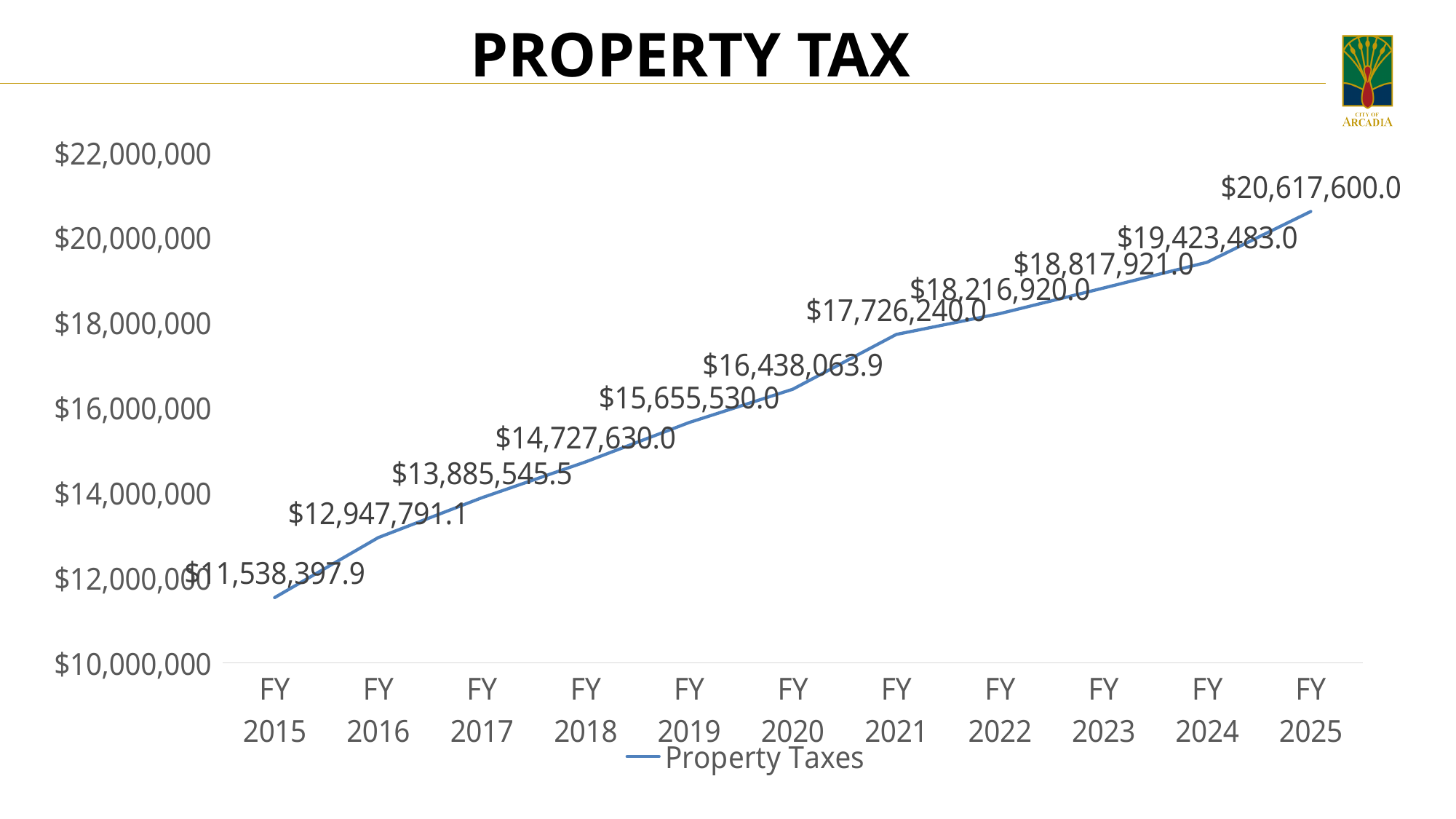
How many series does the legend list? 1 What is the value of Property Taxes for FY 2023? $18,817,921.0 What is the value of Property Taxes for FY 2020? $16,438,063.9 Do the Property Taxes values rise or fall from FY 2015 to FY 2025? Rise What is the difference between the Property Taxes values for FY 2025 and FY 2024? $1,194,117.0 Which fiscal year has the lowest Property Taxes value? FY 2015 What is the value of Property Taxes for FY 2015? $11,538,397.9 What is the value of Property Taxes for FY 2025? $20,617,600.0 Which is larger, the Property Taxes value for FY 2018 or for FY 2019? FY 2019 How many fiscal years are plotted on the chart? 11 What type of chart is shown on the slide? Line chart Which fiscal year has the highest Property Taxes value? FY 2025